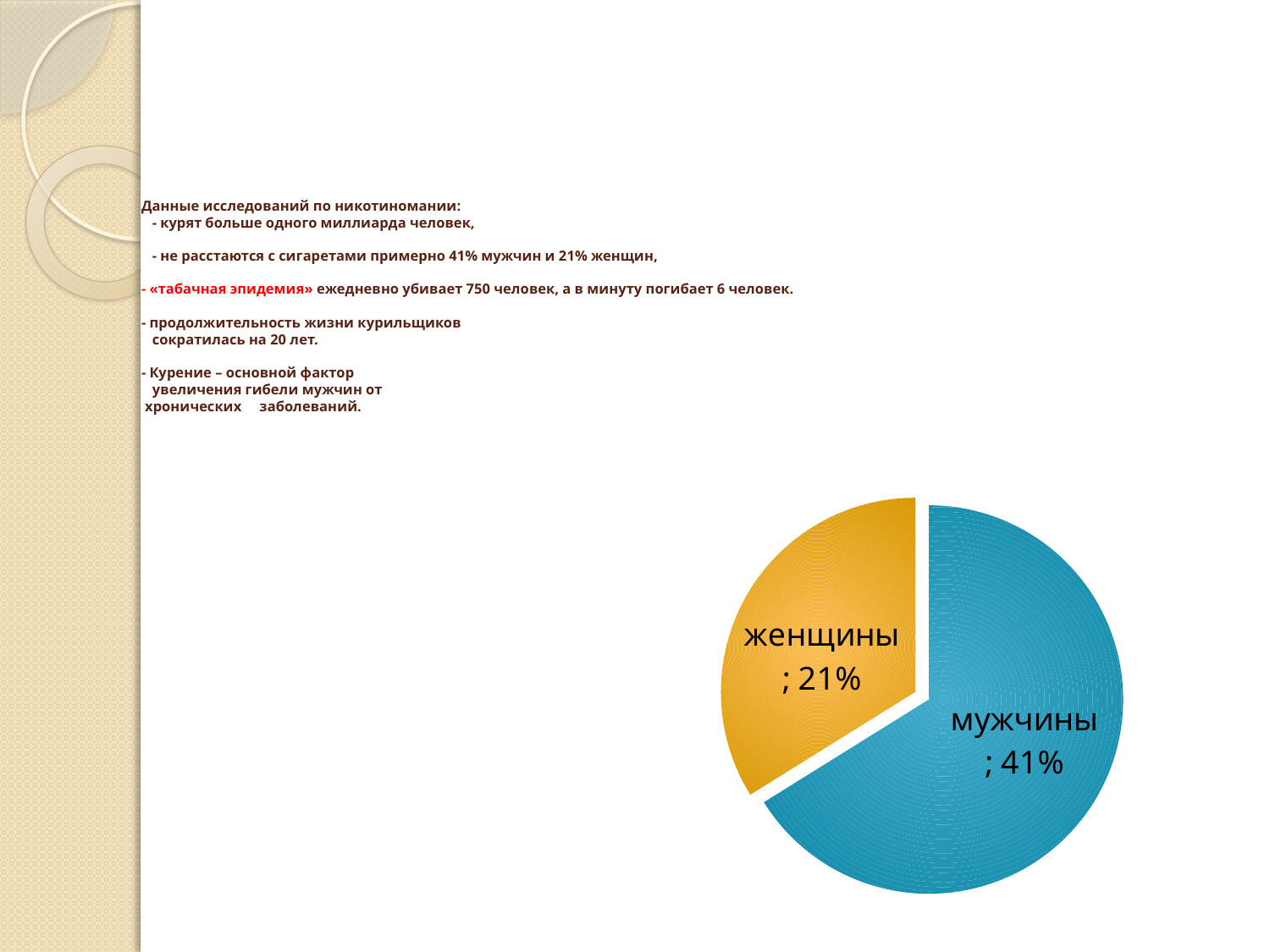
Which category has the smallest slice in the pie chart? женщины What colour is the женщины slice of the pie chart? yellow Which category has the largest slice in the pie chart? мужчины What value is shown for the мужчины slice of the pie chart? 41% What value is shown for the женщины slice of the pie chart? 21% Which slice is larger, мужчины or женщины? мужчины What colour is the мужчины slice of the pie chart? blue What kind of chart is shown on the slide? pie chart By how many percentage points does the мужчины value exceed the женщины value? 20 How many slices does the pie chart have? 2